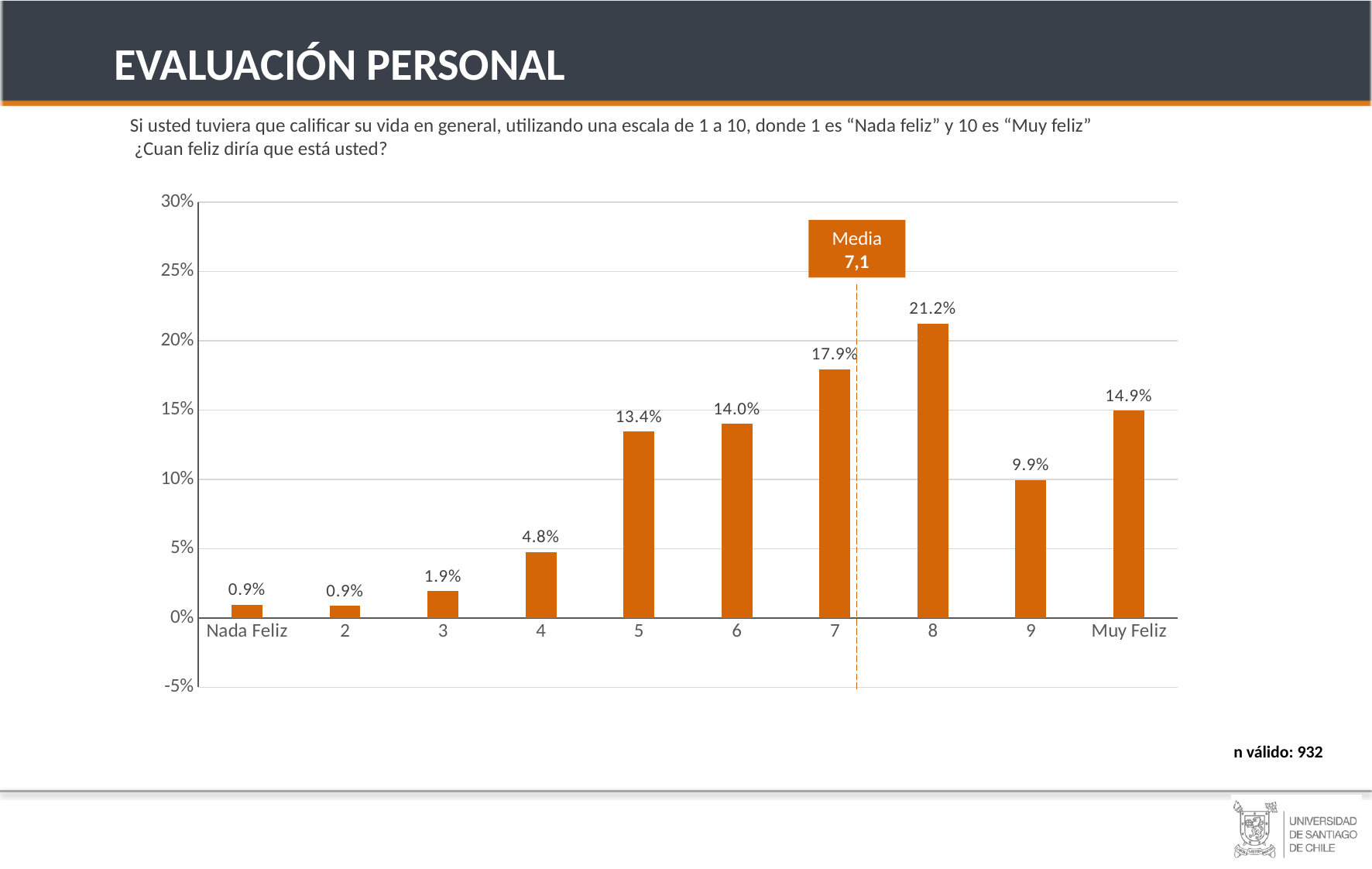
Do the values rise or fall from 'Nada Feliz' to 5? Rise What percentage is shown for the rating of 5? 13.4% How many categories are shown on the x axis? 10 What kind of chart is shown on the slide? Bar chart What percentage of respondents rated their happiness as 8? 21.2% Which is larger, the value for 6 or the value for 9? 6 What mean (Media) value is shown in the box on the chart? 7,1 What is the valid sample size (n válido) shown on the slide? 932 What is the value shown for the 'Muy Feliz' category? 14.9% What is the difference between the values for 8 and 7? 3.3% Which category has the highest value? 8 Is the value for 7 greater or less than 15%? greater